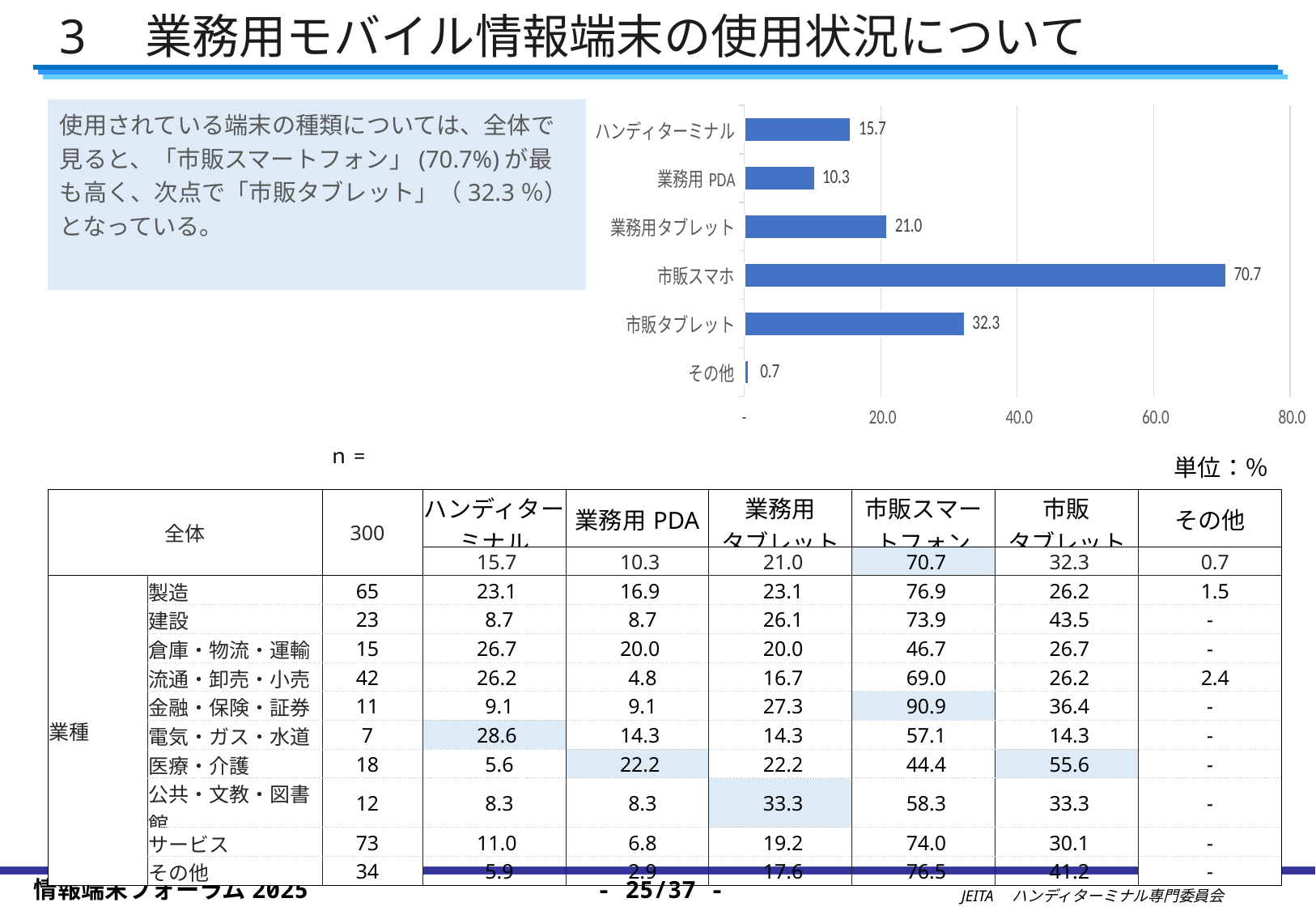
What is the value for 業務用PDA in the bar chart? 10.3 What is the value for ハンディターミナル in the bar chart? 15.7 How many categories are shown in the bar chart? 6 Which category has the lowest value in the bar chart? その他 Which category has the highest value in the bar chart? 市販スマホ What is the maximum value shown on the horizontal axis of the bar chart? 80.0 What is the difference between the values for 市販スマホ and 市販タブレット in the bar chart? 38.4 What kind of chart is shown on the slide? bar chart What is the value for 市販タブレット in the bar chart? 32.3 Which is larger in the bar chart, 業務用タブレット or ハンディターミナル? 業務用タブレット What is the value for 市販スマホ in the bar chart? 70.7 Is the value for 市販スマホ in the bar chart greater or less than 60.0? greater